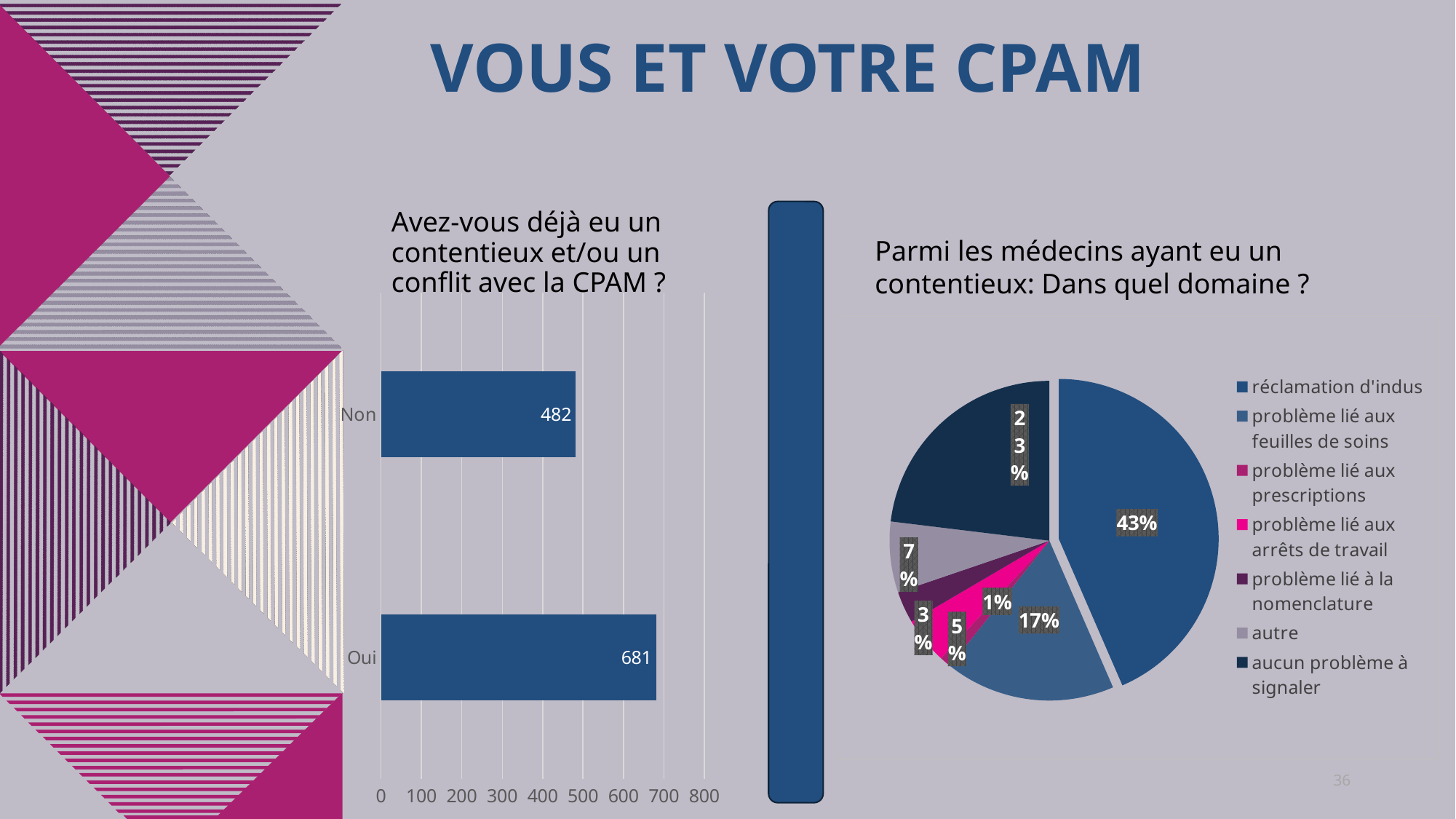
In the bar chart on the left, what is the value for "Non"? 482 In the bar chart on the left, which category has the larger value, "Oui" or "Non"? Oui In the bar chart on the left, what is the value for "Oui"? 681 What kind of chart is the chart on the left of the slide? Bar chart In the bar chart on the left, what is the difference between the values for "Oui" and "Non"? 199 In the bar chart on the left, is the value for "Non" greater or less than 500? less In the pie chart on the right, what share is "problème lié aux feuilles de soins"? 17% In the pie chart on the right, which category has the largest slice? réclamation d'indus In the pie chart on the right, what share is "aucun problème à signaler"? 23% How many entries does the legend of the pie chart on the right list? 7 In the pie chart on the right, what share is "réclamation d'indus"? 43% How many categories are shown in the bar chart on the left? 2